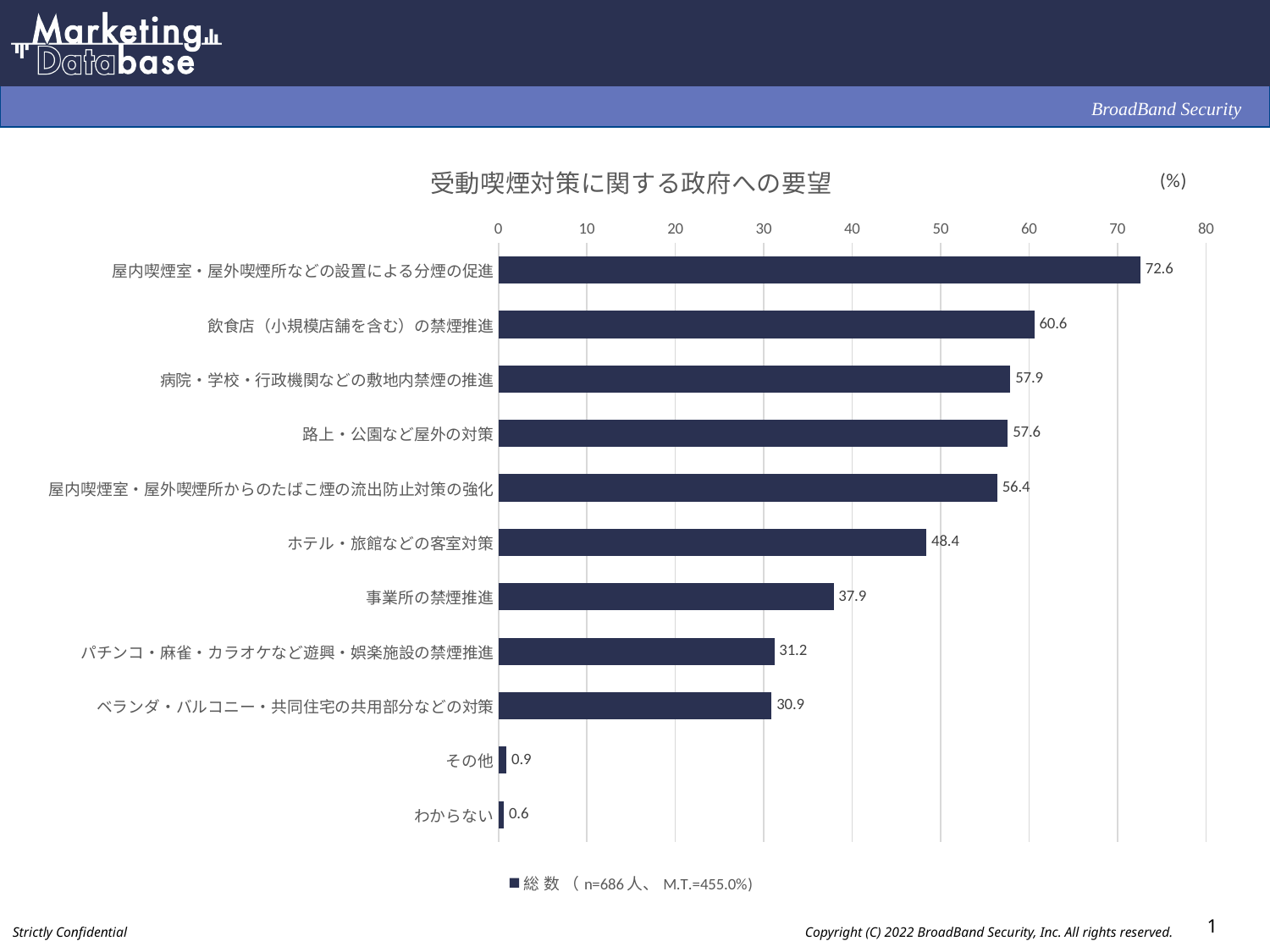
What kind of chart is shown on the slide? bar chart How many categories are shown in the chart? 11 How many series does the legend list? 1 Which is larger, the value for ホテル・旅館などの客室対策 or the value for パチンコ・麻雀・カラオケなど遊興・娯楽施設の禁煙推進? ホテル・旅館などの客室対策 What is the value for ホテル・旅館などの客室対策? 48.4 What is the difference between the values for 飲食店（小規模店舗を含む）の禁煙推進 and 事業所の禁煙推進? 22.7 Which category has the lowest value? わからない What is the title of the chart? 受動喫煙対策に関する政府への要望 What is the value for 事業所の禁煙推進? 37.9 Is the value for 路上・公園など屋外の対策 greater or less than 50? greater Which category has the highest value? 屋内喫煙室・屋外喫煙所などの設置による分煙の促進 What is the value for 屋内喫煙室・屋外喫煙所などの設置による分煙の促進? 72.6